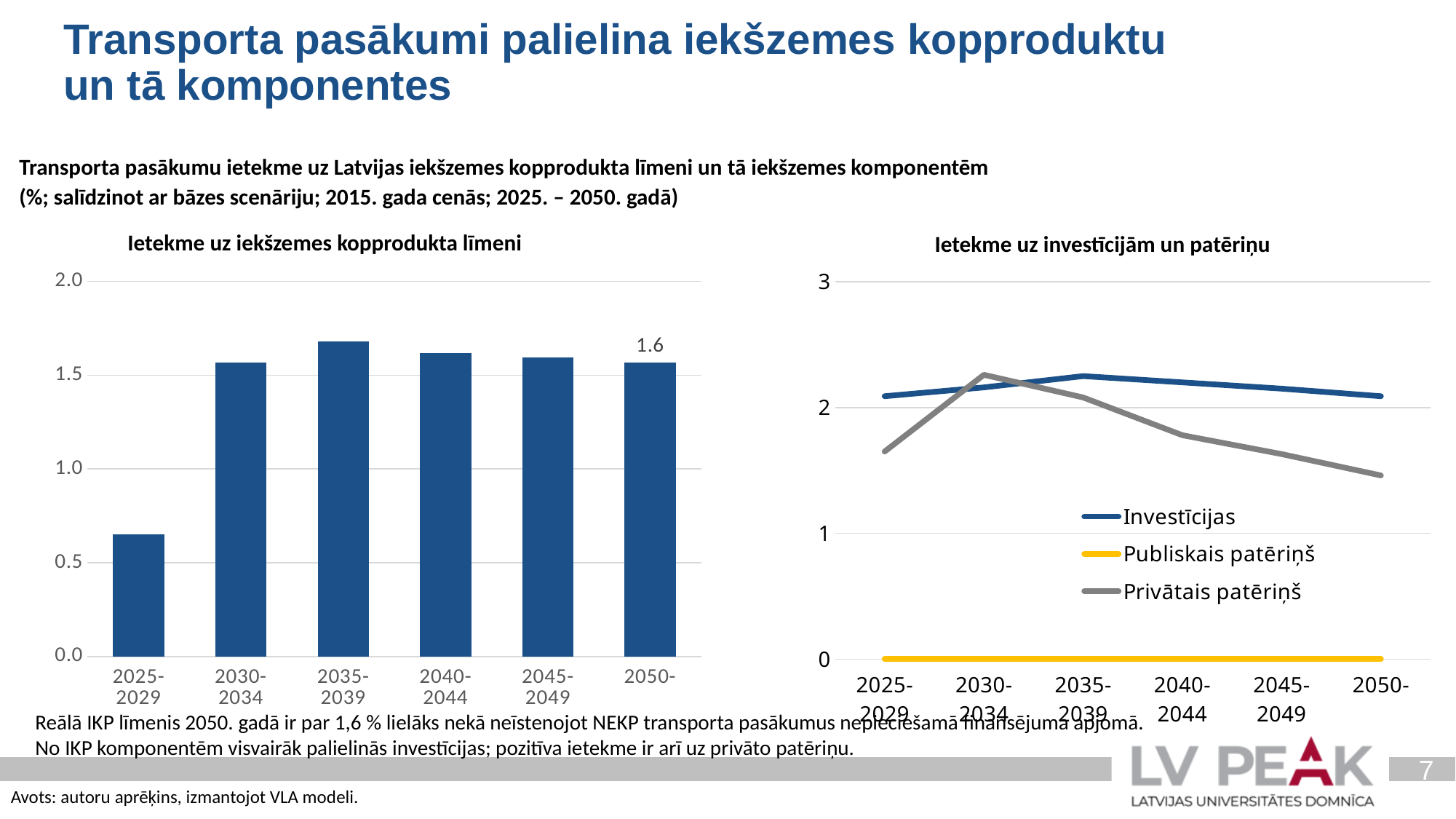
In the right chart "Ietekme uz investīcijām un patēriņu", is the value of Publiskais patēriņš at 2040-2044 greater or less than 1? less In the right chart "Ietekme uz investīcijām un patēriņu", does the Privātais patēriņš line rise or fall from 2030-2034 to 2050-? fall In the left chart "Ietekme uz iekšzemes kopprodukta līmeni", which period has the highest bar? 2035-2039 In the right chart "Ietekme uz investīcijām un patēriņu", which is larger at 2050-: Investīcijas or Privātais patēriņš? Investīcijas In the left chart "Ietekme uz iekšzemes kopprodukta līmeni", what is the value for 2050-? 1.6 In the left chart "Ietekme uz iekšzemes kopprodukta līmeni", which period has the lowest bar? 2025-2029 How many series does the legend of the right chart "Ietekme uz investīcijām un patēriņu" list? 3 What kind of chart is the left chart titled "Ietekme uz iekšzemes kopprodukta līmeni"? bar chart In the left chart "Ietekme uz iekšzemes kopprodukta līmeni", is the value for 2035-2039 greater or less than 1.5? greater In the left chart "Ietekme uz iekšzemes kopprodukta līmeni", is the value for 2025-2029 greater or less than 1.0? less How many periods are shown on the x axis of the left chart "Ietekme uz iekšzemes kopprodukta līmeni"? 6 What kind of chart is the right chart titled "Ietekme uz investīcijām un patēriņu"? line chart